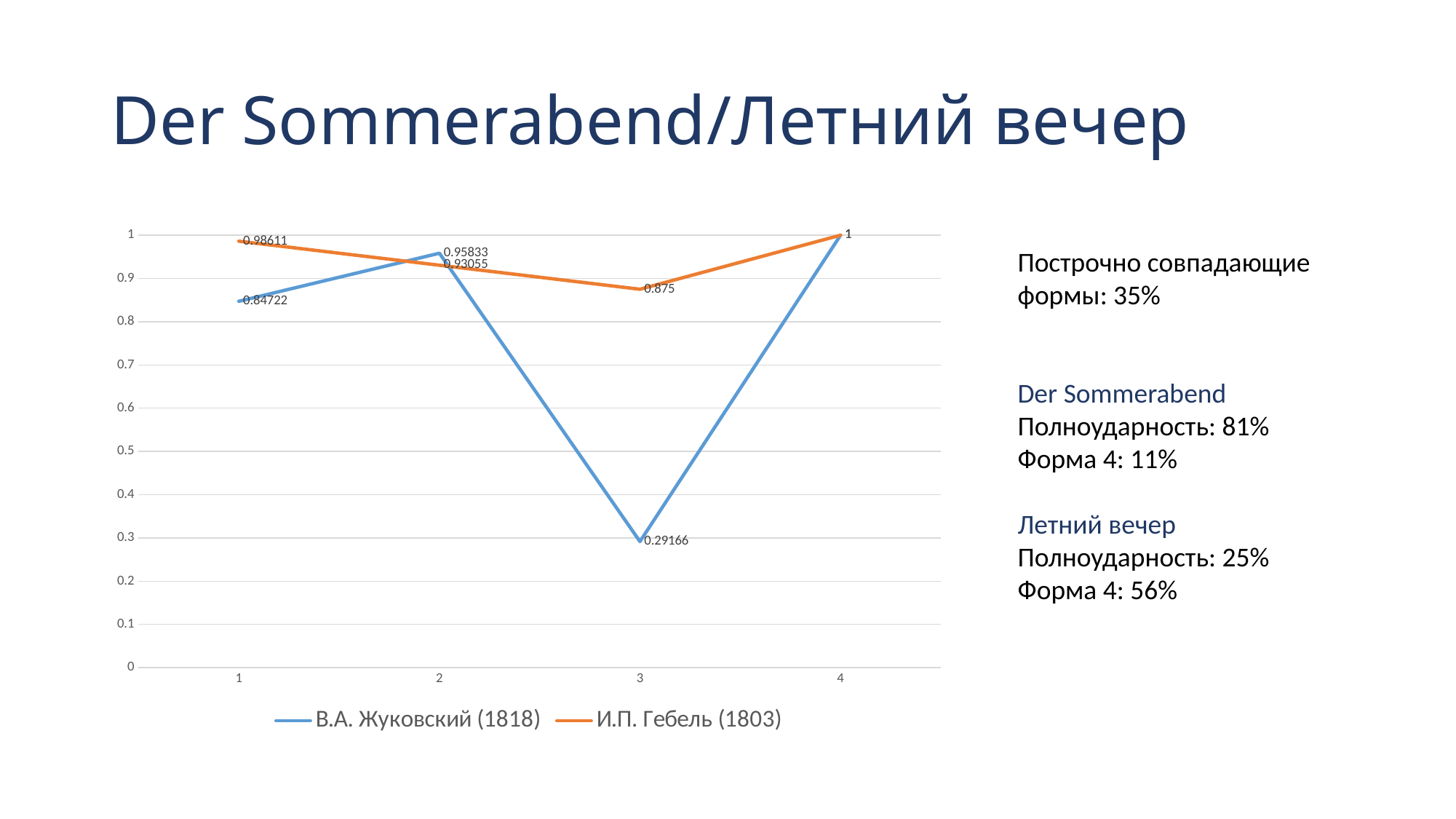
At which point does the И.П. Гебель (1803) series reach its highest value? 4 What is the value for И.П. Гебель (1803) at point 1? 0.98611 How many points are plotted along the x axis for each series? 4 At which point does the В.А. Жуковский (1818) series reach its lowest value? 3 What is the value for В.А. Жуковский (1818) at point 1? 0.84722 Which series has the larger value at point 1, В.А. Жуковский (1818) or И.П. Гебель (1803)? И.П. Гебель (1803) What is the difference between the И.П. Гебель (1803) and В.А. Жуковский (1818) values at point 3? 0.58334 What is the value for И.П. Гебель (1803) at point 3? 0.875 How many series does the chart legend list? 2 What is the value for В.А. Жуковский (1818) at point 3? 0.29166 Which colour is used for the В.А. Жуковский (1818) line? blue What kind of chart is shown on the slide? line chart